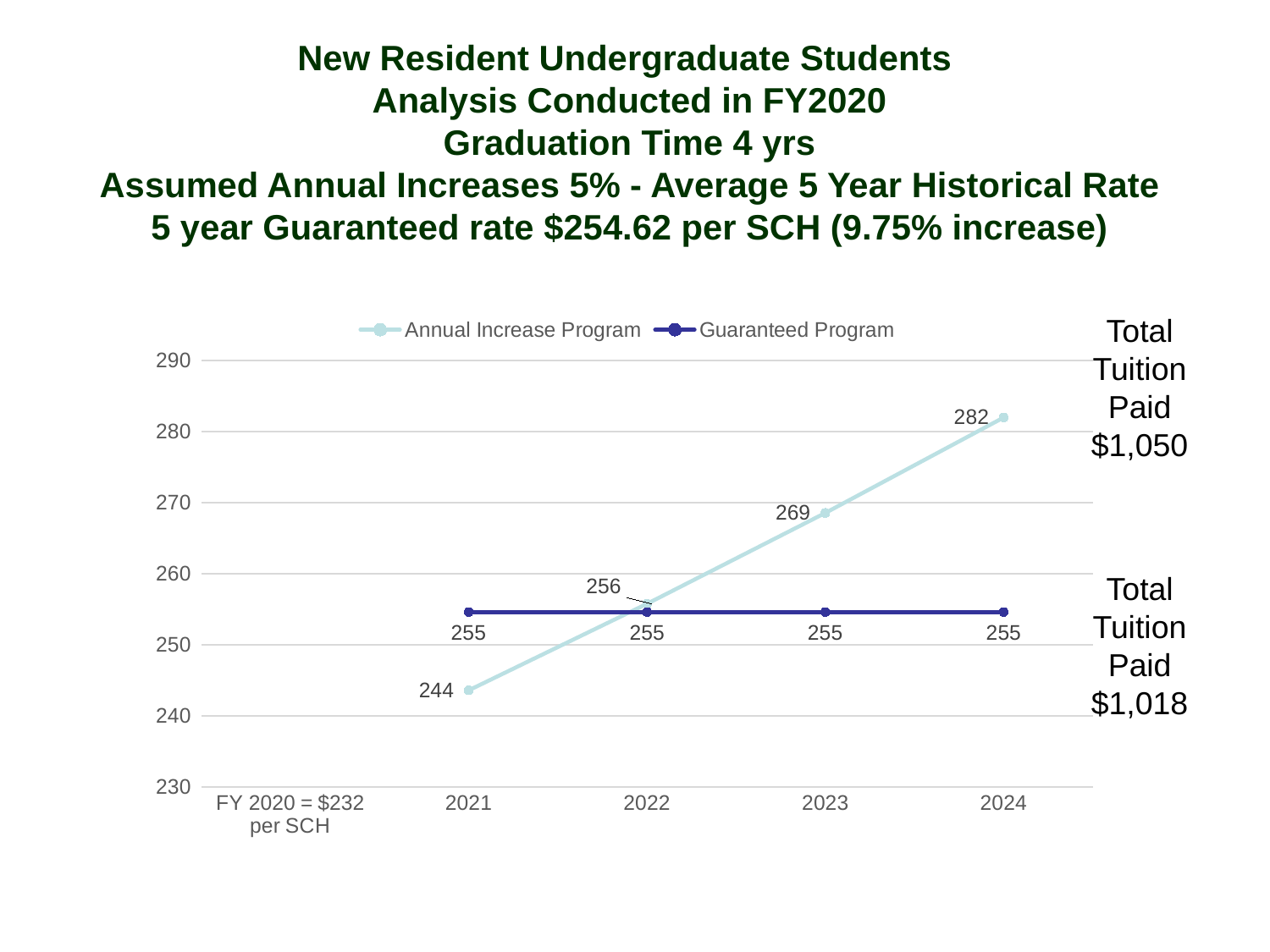
What is the difference between the Annual Increase Program and the Guaranteed Program values in 2024? 27 In which year is the Annual Increase Program value lowest? 2021 What is the value for the Annual Increase Program in 2022? 256 Is the Annual Increase Program value in 2023 greater or less than 260? greater What kind of chart is shown on the slide? Line chart In which year is the Annual Increase Program value highest? 2024 What is the value for the Guaranteed Program in 2023? 255 What is the value for the Annual Increase Program in 2021? 244 How many series does the legend list? 2 Which series has the larger value in 2021, Annual Increase Program or Guaranteed Program? Guaranteed Program What is the value for the Annual Increase Program in 2024? 282 Do the Annual Increase Program values rise or fall from 2021 to 2024? Rise